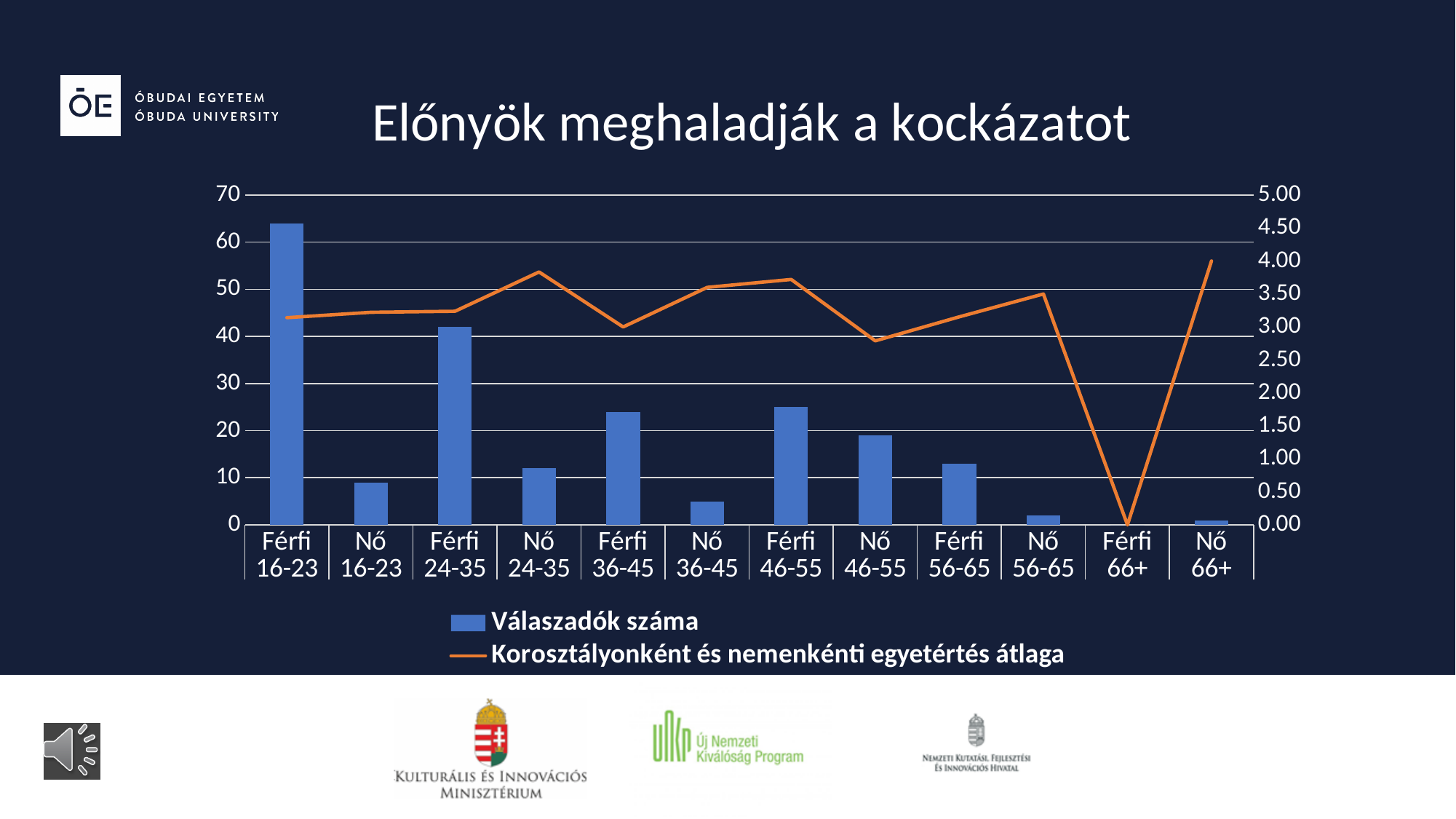
Which has more Válaszadók száma: Férfi 24-35 or Férfi 36-45? Férfi 24-35 What kind of chart is shown on the slide? A combined bar and line chart What is the title of the chart on the slide? Előnyök meghaladják a kockázatot Which has more Válaszadók száma: Nő 46-55 or Nő 56-65? Nő 46-55 How many series does the legend list? 2 What is the value of the Korosztályonként és nemenkénti egyetértés átlaga line for Férfi 66+? 0.00 Is the Korosztályonként és nemenkénti egyetértés átlaga value for Nő 46-55 greater or less than 3.00? less How many categories are shown on the x axis? 12 Is the Válaszadók száma value for Nő 36-45 greater or less than 10? less Which category has the highest value for Válaszadók száma? Férfi 16-23 Is the Válaszadók száma value for Férfi 16-23 greater or less than 60? greater Which category has the lowest value on the Korosztályonként és nemenkénti egyetértés átlaga line? Férfi 66+